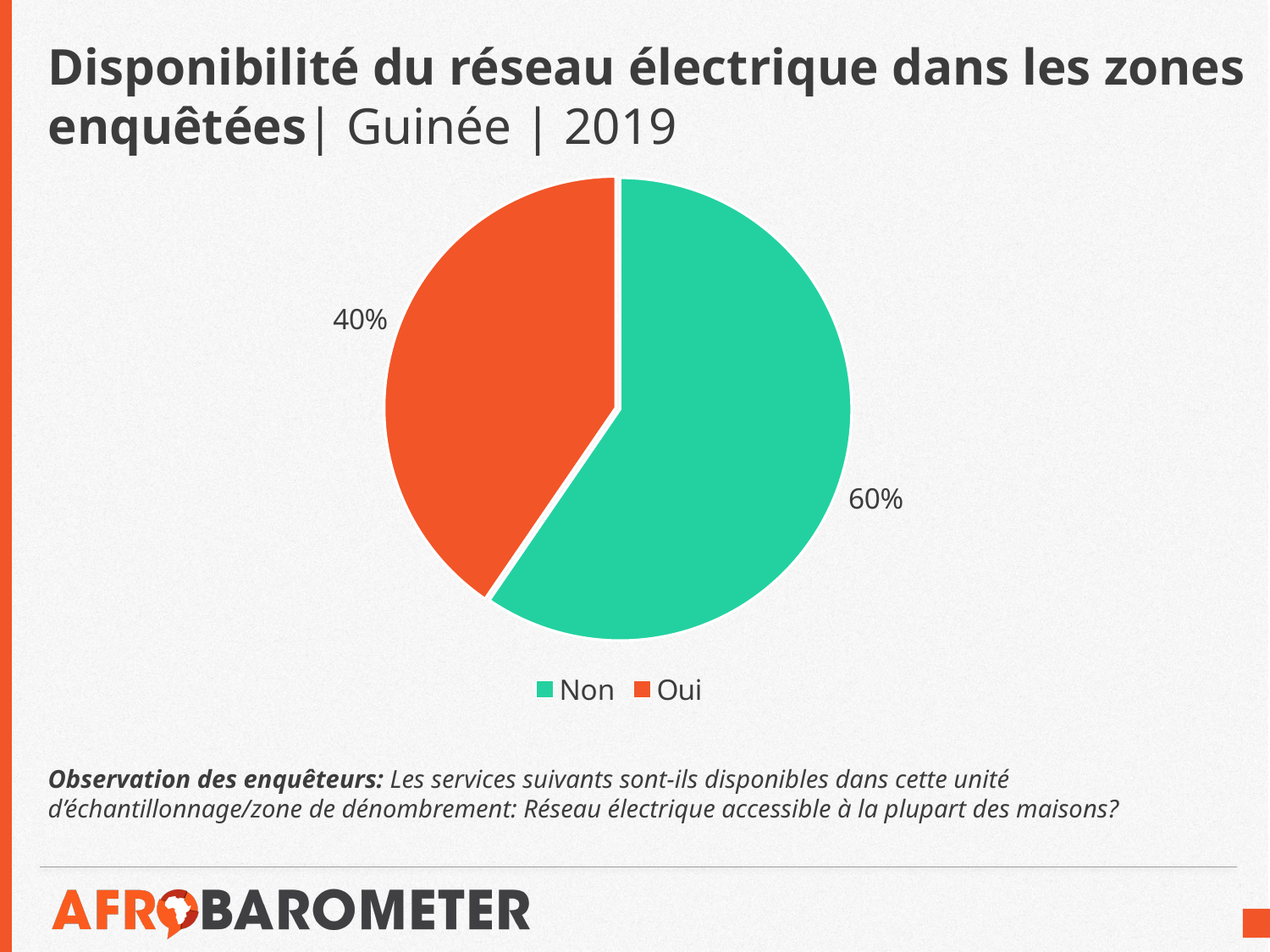
What share of the pie does the "Oui" slice represent? 40% Which is larger, the share for "Non" or the share for "Oui"? Non How many entries does the legend list? 2 Which category has the largest share of the pie? Non What colour is the "Non" slice? green What kind of chart is shown on the slide? pie chart What percentage of surveyed zones answered "Non"? 60% What percentage of surveyed zones answered "Oui"? 40% Which country and year does the chart title refer to? Guinée, 2019 Which category has the smallest share of the pie? Oui How many slices does the pie chart have? 2 What is the difference in percentage points between "Non" and "Oui"? 20